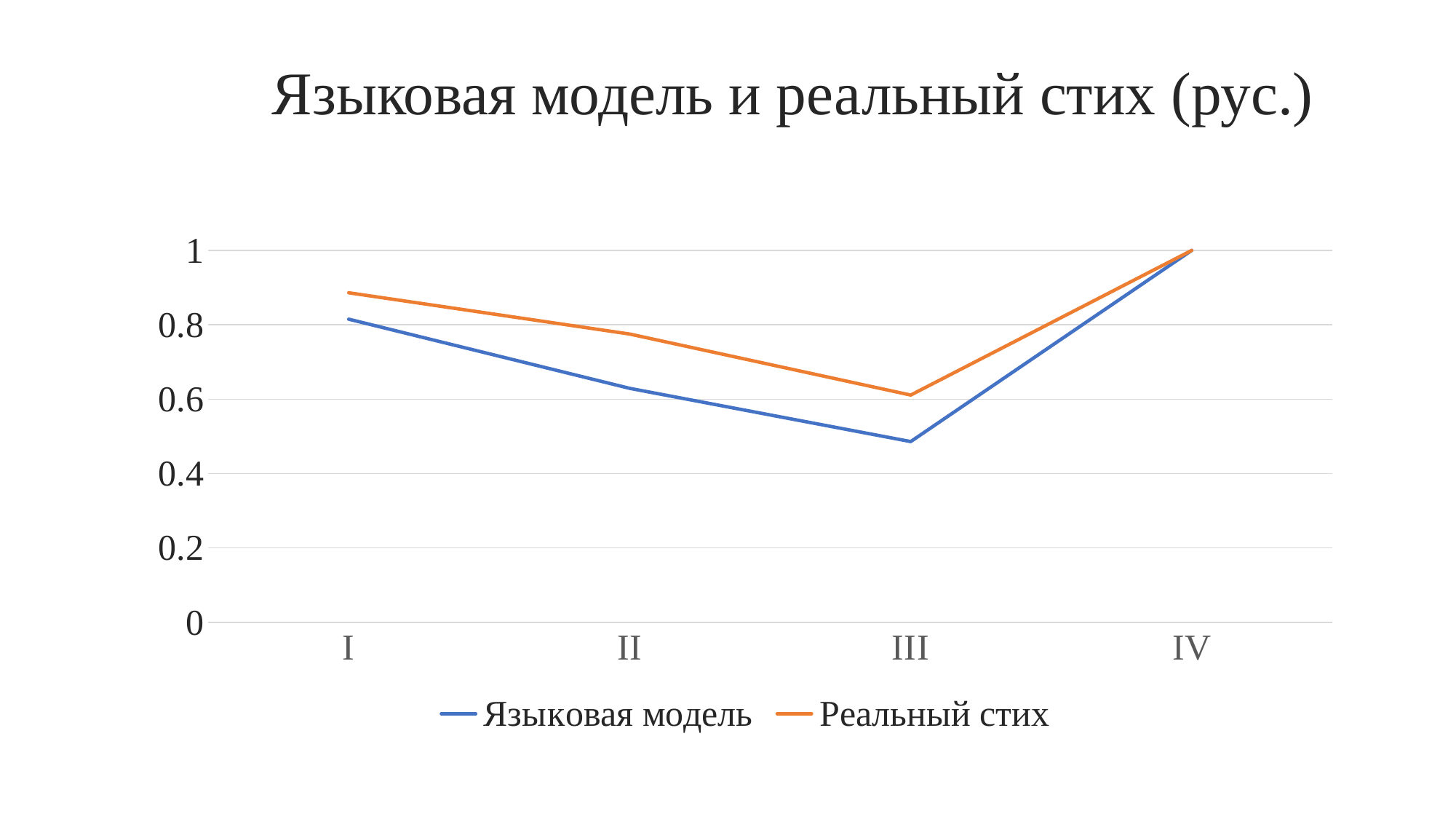
At which category does the Языковая модель series reach its lowest value? III At category II, which series has the larger value, Языковая модель or Реальный стих? Реальный стих What is the title of the chart? Языковая модель и реальный стих (рус.) Is the value of the Языковая модель series at III greater or less than 0.6? less How many categories are shown on the x axis? 4 Do the values of the Языковая модель series rise or fall from I to III? fall Is the value of the Реальный стих series at I greater or less than 0.8? greater At which category does the Реальный стих series reach its lowest value? III Which series is drawn in orange? Реальный стих What kind of chart is shown on the slide? line chart What is the value of the Языковая модель series at IV? 1 How many series does the legend list? 2